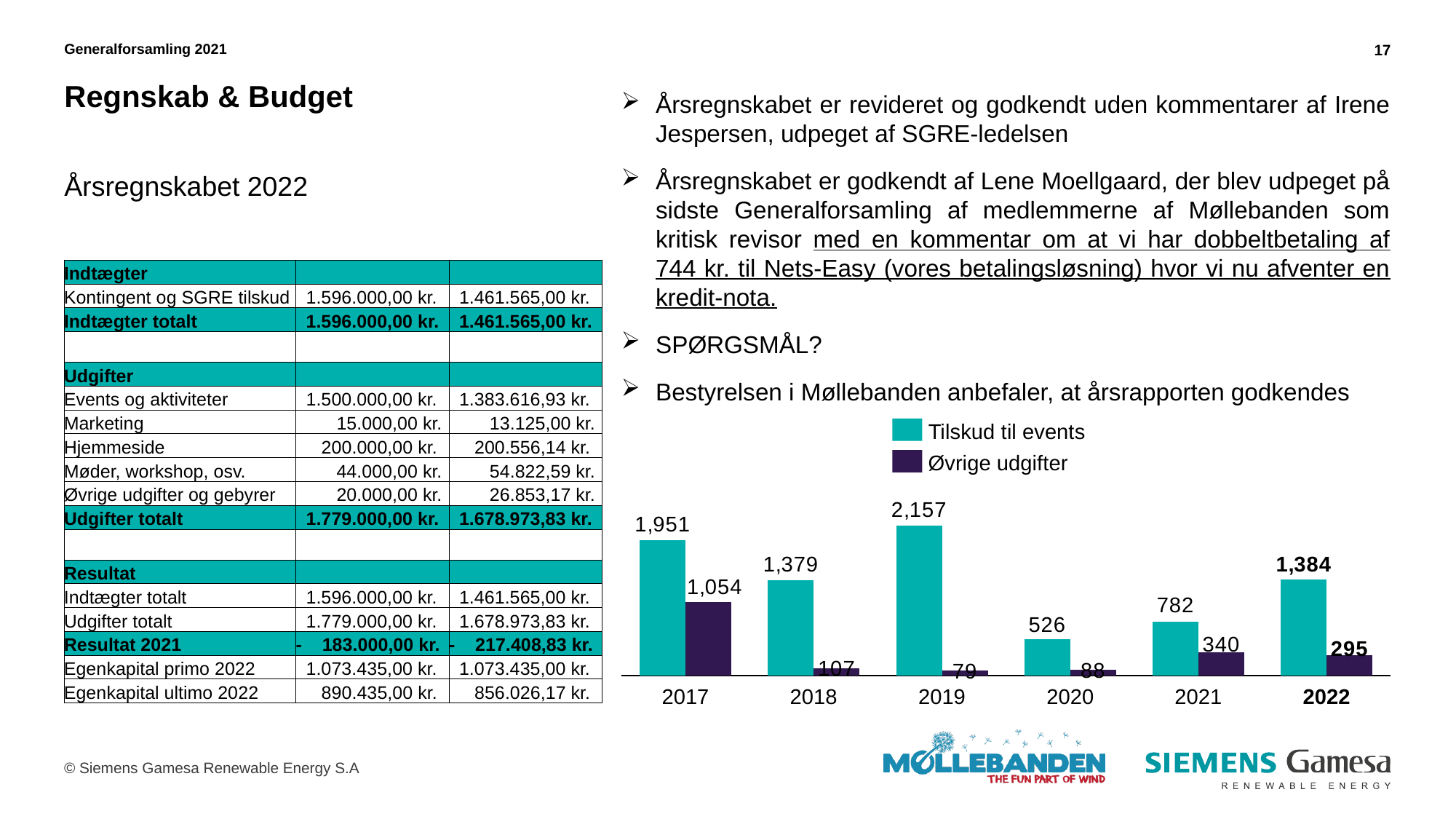
Which year has the highest value for Tilskud til events? 2019 Which is larger: Øvrige udgifter in 2021 or Øvrige udgifter in 2022? 2021 How many series does the chart legend list? 2 Which year has the lowest value for Tilskud til events? 2020 What is the value of Øvrige udgifter for 2021? 340 What is the value of Tilskud til events for 2019? 2,157 Which series in the chart is shown in teal? Tilskud til events What is the difference between Tilskud til events in 2019 and in 2020? 1,631 What is the value of Tilskud til events for 2022? 1,384 How many years are shown on the x axis of the chart? 6 What is the value of Øvrige udgifter for 2017? 1,054 What type of chart is shown on the slide? bar chart